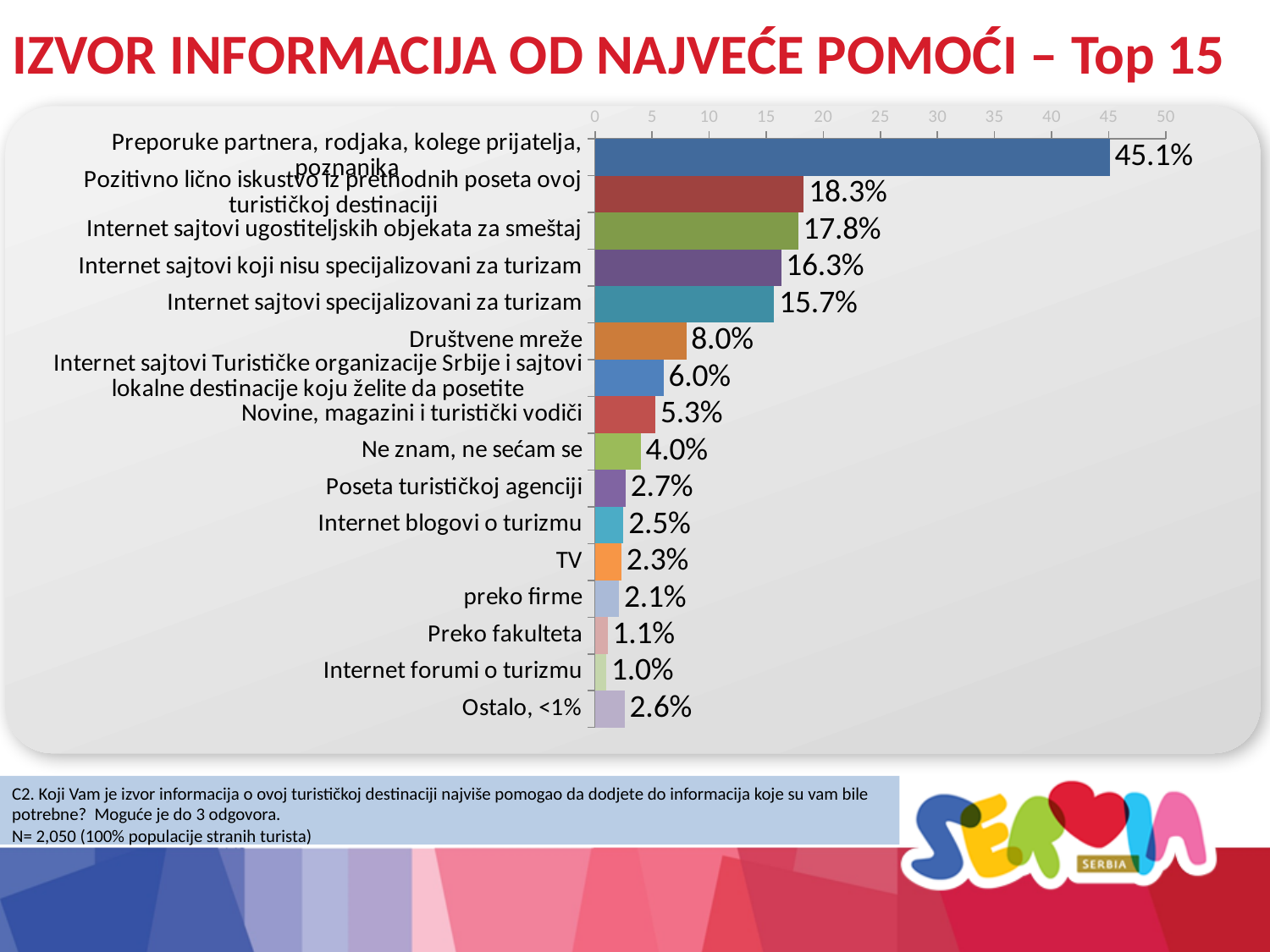
What is the value for "Internet sajtovi specijalizovani za turizam"? 15.7% What is the value for "Društvene mreže"? 8.0% What is the difference between the values for "Pozitivno lično iskustvo iz prethodnih poseta ovoj turističkoj destinaciji" and "Internet sajtovi ugostiteljskih objekata za smeštaj"? 0.5% What is the value for "TV"? 2.3% Which is larger: the value for "Poseta turističkoj agenciji" or the value for "Internet blogovi o turizmu"? Poseta turističkoj agenciji Which category has the highest value? Preporuke partnera, rodjaka, kolege prijatelja, poznanika Is the value for "Internet sajtovi koji nisu specijalizovani za turizam" greater or less than 15? greater How many bars are plotted in the chart? 16 What is the title of the slide? IZVOR INFORMACIJA OD NAJVEĆE POMOĆI – Top 15 What is the value for "Ne znam, ne sećam se"? 4.0% What type of chart is shown on the slide? Bar chart Which category has the lowest value? Internet forumi o turizmu